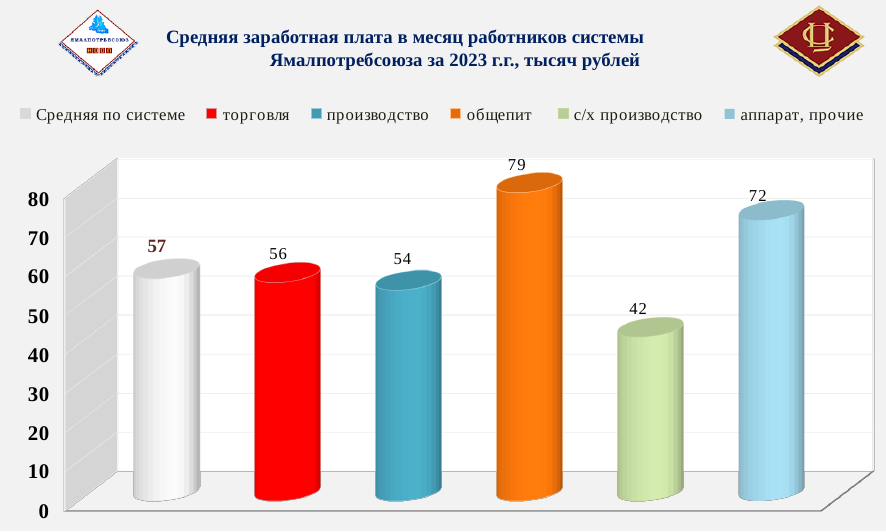
How many entries does the legend list? 6 What kind of chart is shown on the slide? bar chart Which category has the highest value? общепит How many bars are plotted on the chart? 6 Which is larger, the value for торговля or the value for аппарат, прочие? аппарат, прочие What is the value for аппарат, прочие? 72 What is the value for общепит? 79 What is the value for с/х производство? 42 What is the difference between the values for аппарат, прочие and производство? 18 Which category has the lowest value? с/х производство What is the value for Средняя по системе? 57 What is the difference between the values for общепит and с/х производство? 37